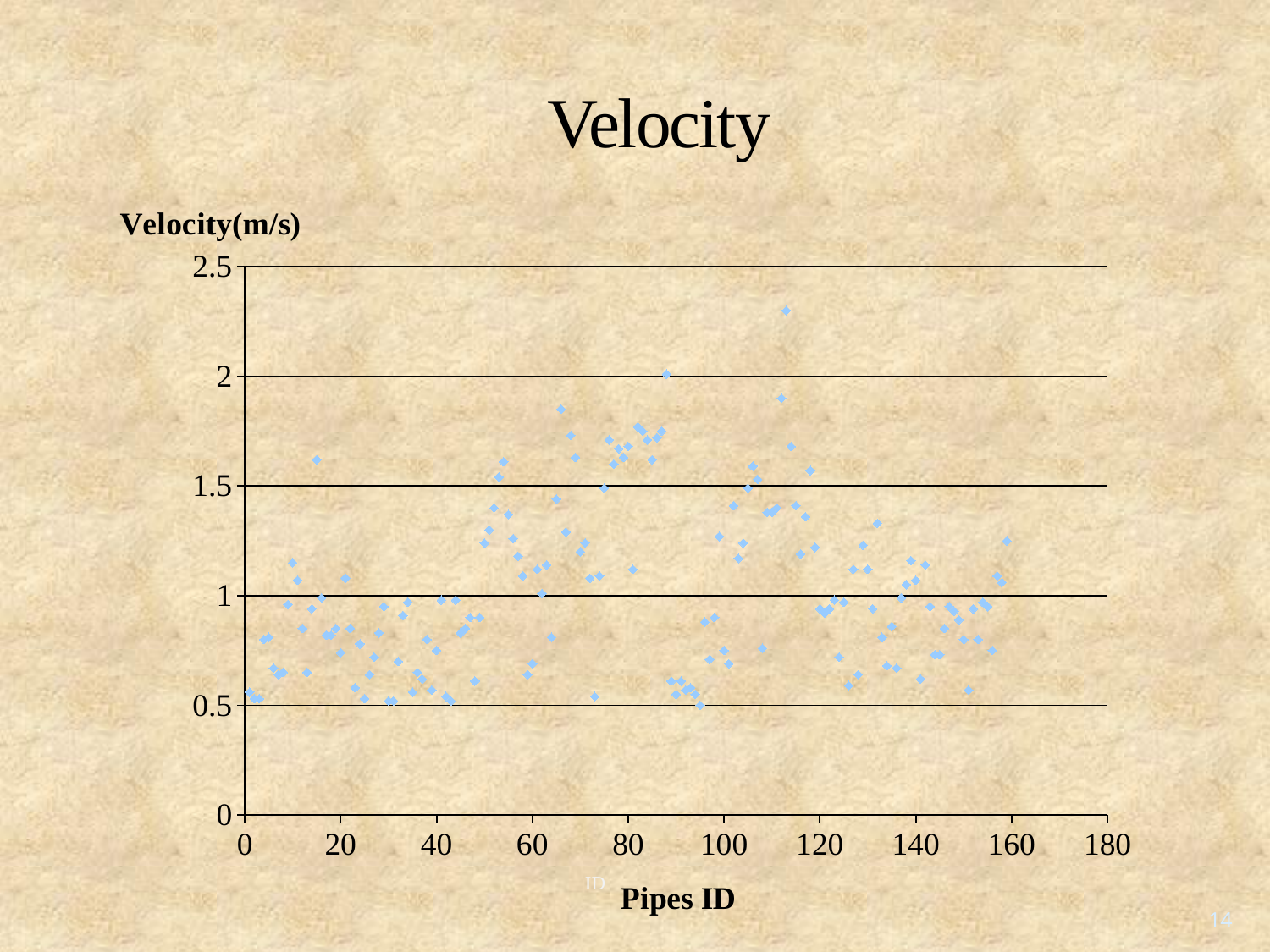
What is the highest tick value shown on the x axis? 180 What is the label of the x axis of the chart? Pipes ID Is the highest plotted velocity value greater or less than 2.5? less Is the highest plotted velocity value greater or less than 1.5? greater What is the title of the chart? Velocity Is the highest plotted velocity value greater or less than 2? greater What kind of chart is shown on the slide? scatter chart What is the highest tick value shown on the y axis? 2.5 How many data series are plotted on the chart? 1